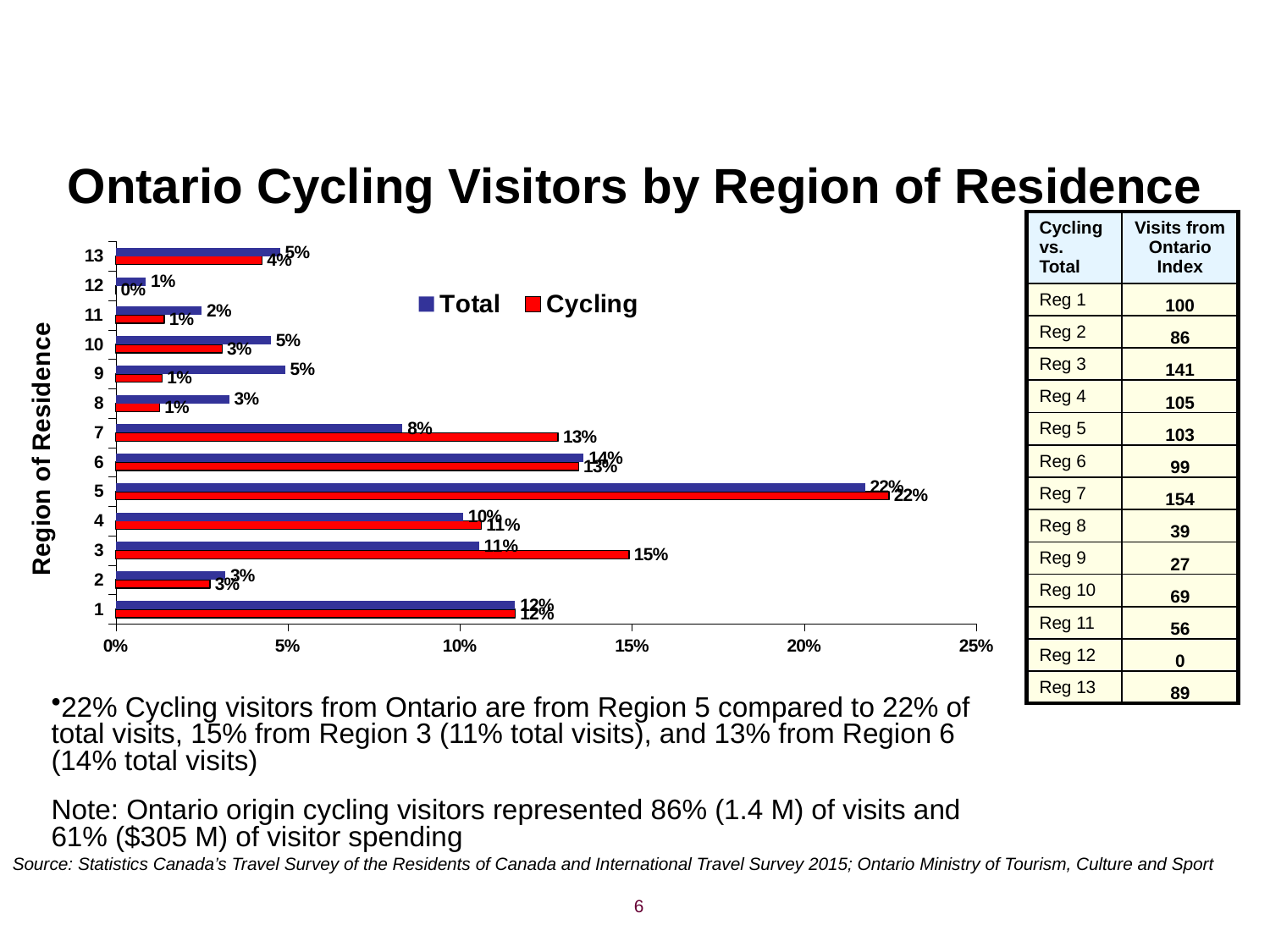
What is the Cycling value for Region 3? 15% What is the Cycling value for Region 12? 0% What kind of chart is shown on the slide? Bar chart What is the Cycling value for Region 7? 13% What is the Total value for Region 9? 5% How many series does the chart's legend list? 2 By how many percentage points does the Cycling value for Region 3 exceed its Total value? 4 percentage points How many regions of residence are plotted on the chart? 13 What is the Total value for Region 7? 8% Which region has the highest Cycling value? Region 5 What are the two entries in the chart's legend? Total and Cycling For Region 7, which is larger: the Total value or the Cycling value? Cycling